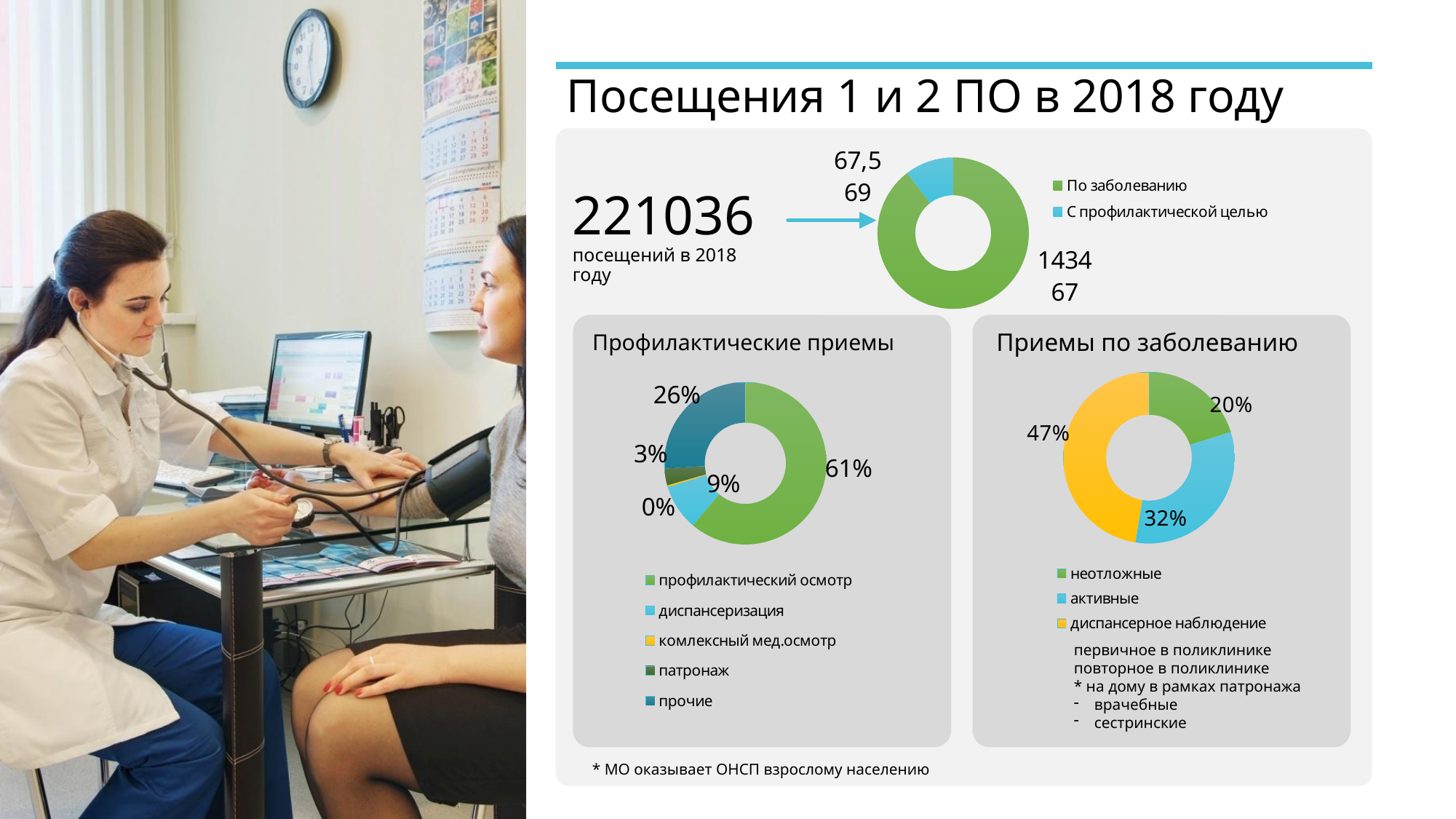
In the chart titled "Приемы по заболеванию", what share is labelled for "диспансерное наблюдение"? 47% In the top donut chart next to "221036", which segment is larger: "По заболеванию" or "С профилактической целью"? По заболеванию In the chart titled "Приемы по заболеванию", what share is labelled for "активные"? 32% In the chart titled "Профилактические приемы", how many entries does the legend list? 5 In the chart titled "Профилактические приемы", what share is labelled for "прочие"? 26% In the chart titled "Профилактические приемы", which category has the largest share? профилактический осмотр In the chart titled "Профилактические приемы", what share is labelled for "профилактический осмотр"? 61% In the chart titled "Профилактические приемы", what share is labelled for "диспансеризация"? 9% In the chart titled "Приемы по заболеванию", which category has the smallest share? неотложные What kind of chart is used for "Приемы по заболеванию"? Donut (pie) chart In the chart titled "Приемы по заболеванию", what is the difference in percentage points between "диспансерное наблюдение" and "неотложные"? 27 In the chart titled "Приемы по заболеванию", how many categories does the legend list? 3